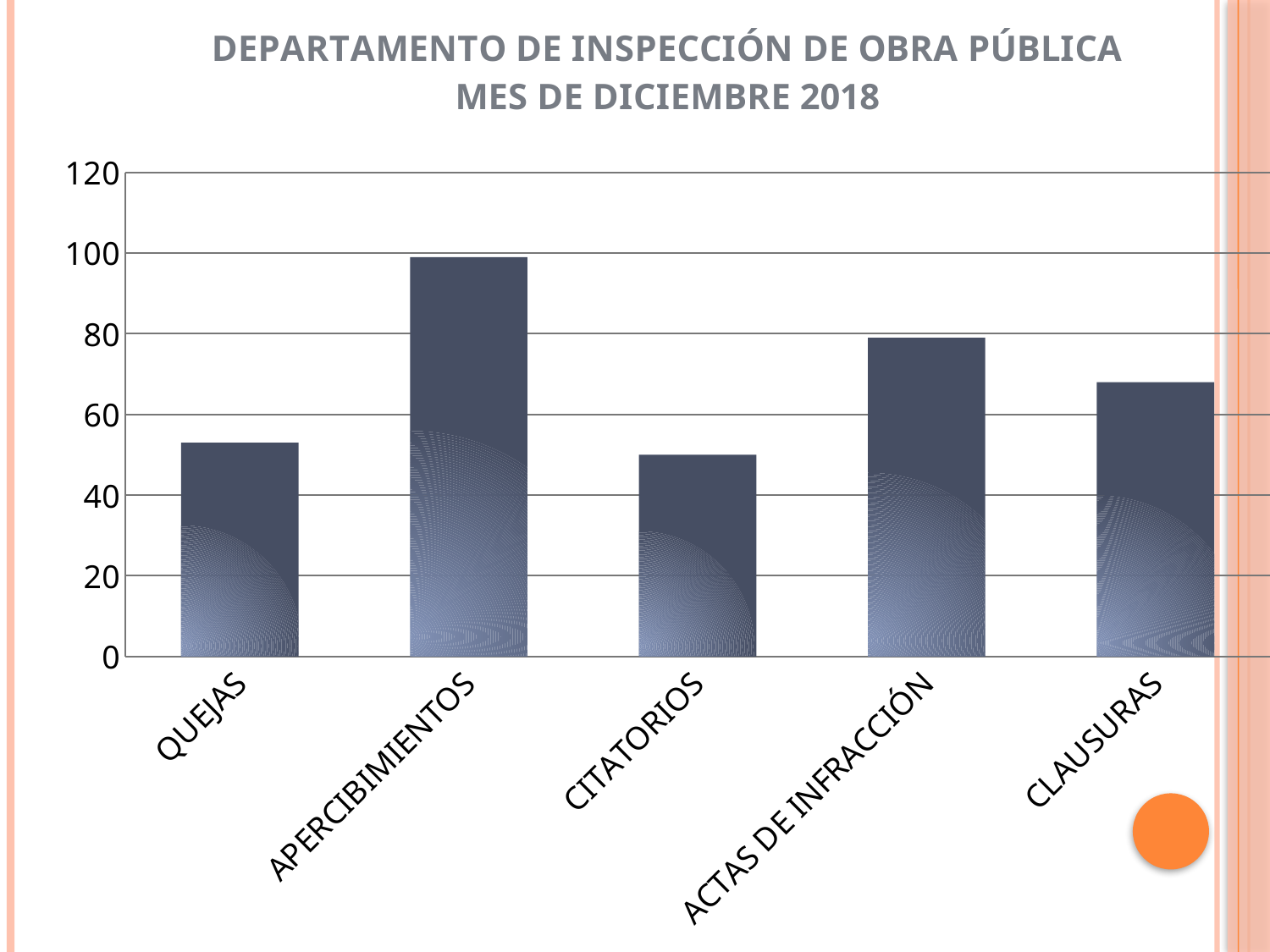
How many categories are shown on the x axis? 5 Is the value for APERCIBIMIENTOS greater or less than 80? greater Is the value for QUEJAS greater or less than 40? greater Is the value for ACTAS DE INFRACCIÓN greater or less than 60? greater Which is larger, the value for ACTAS DE INFRACCIÓN or the value for CLAUSURAS? ACTAS DE INFRACCIÓN Which category has the highest value? APERCIBIMIENTOS Which is larger, the value for QUEJAS or the value for CLAUSURAS? CLAUSURAS What is the title of the chart? DEPARTAMENTO DE INSPECCIÓN DE OBRA PÚBLICA MES DE DICIEMBRE 2018 What kind of chart is shown on the slide? bar chart